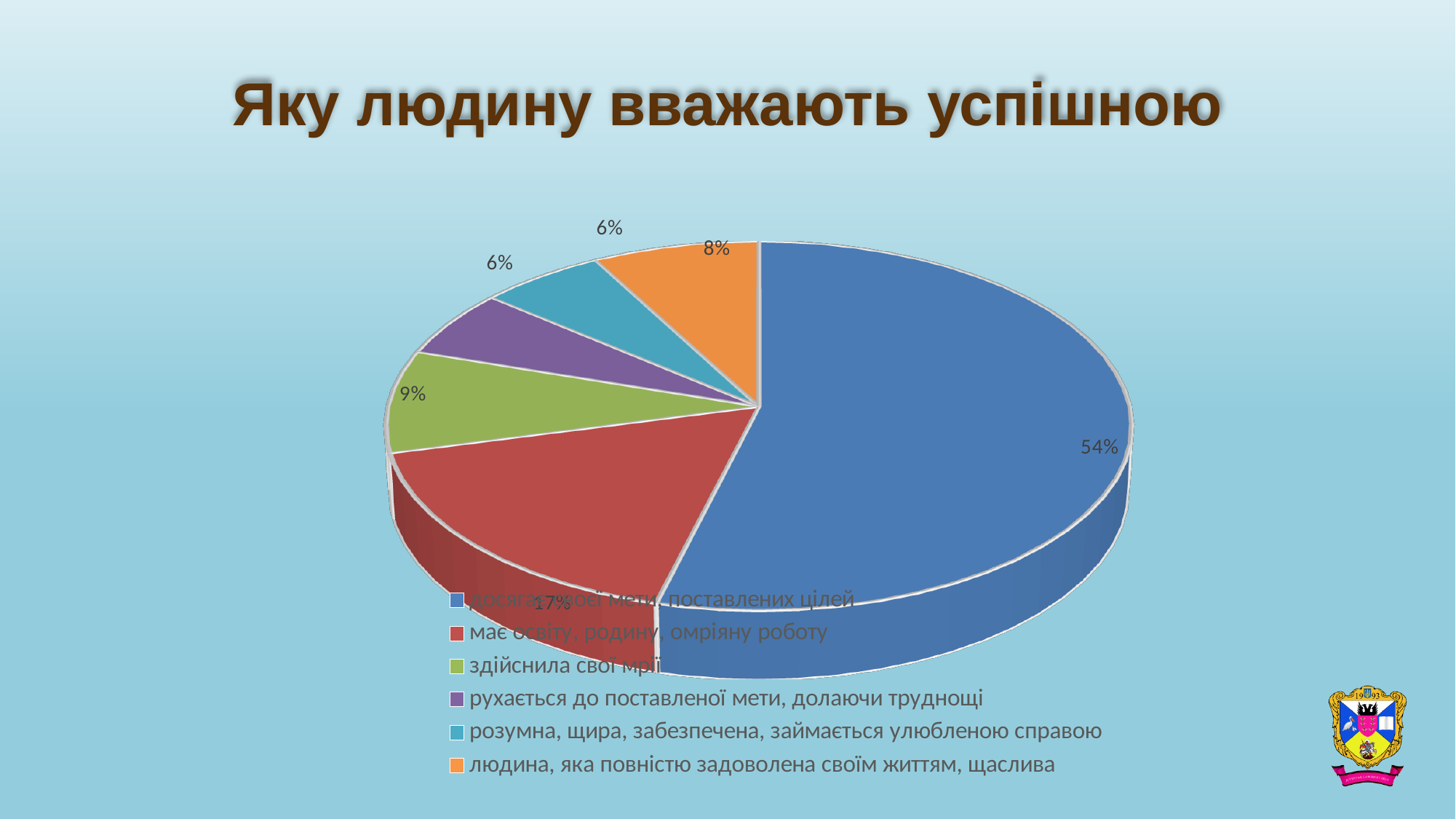
What is the value for "має освіту, родину, омріяну роботу"? 17% Which is larger: the share for "здійснила свої мрії" or the share for "людина, яка повністю задоволена своїм життям, щаслива"? здійснила свої мрії Which category has the largest share of the pie? досягає своєї мети, поставлених цілей What is the title of the chart? Яку людину вважають успішною What is the difference between the shares of "досягає своєї мети, поставлених цілей" and "має освіту, родину, омріяну роботу"? 37% What share of the pie does "досягає своєї мети, поставлених цілей" have? 54% What is the value for "рухається до поставленої мети, долаючи труднощі"? 6% What is the value for "людина, яка повністю задоволена своїм життям, щаслива"? 8% What kind of chart is shown on the slide? pie chart How many entries does the legend list? 6 What is the value for "здійснила свої мрії"? 9% How many slices does the pie chart have? 6